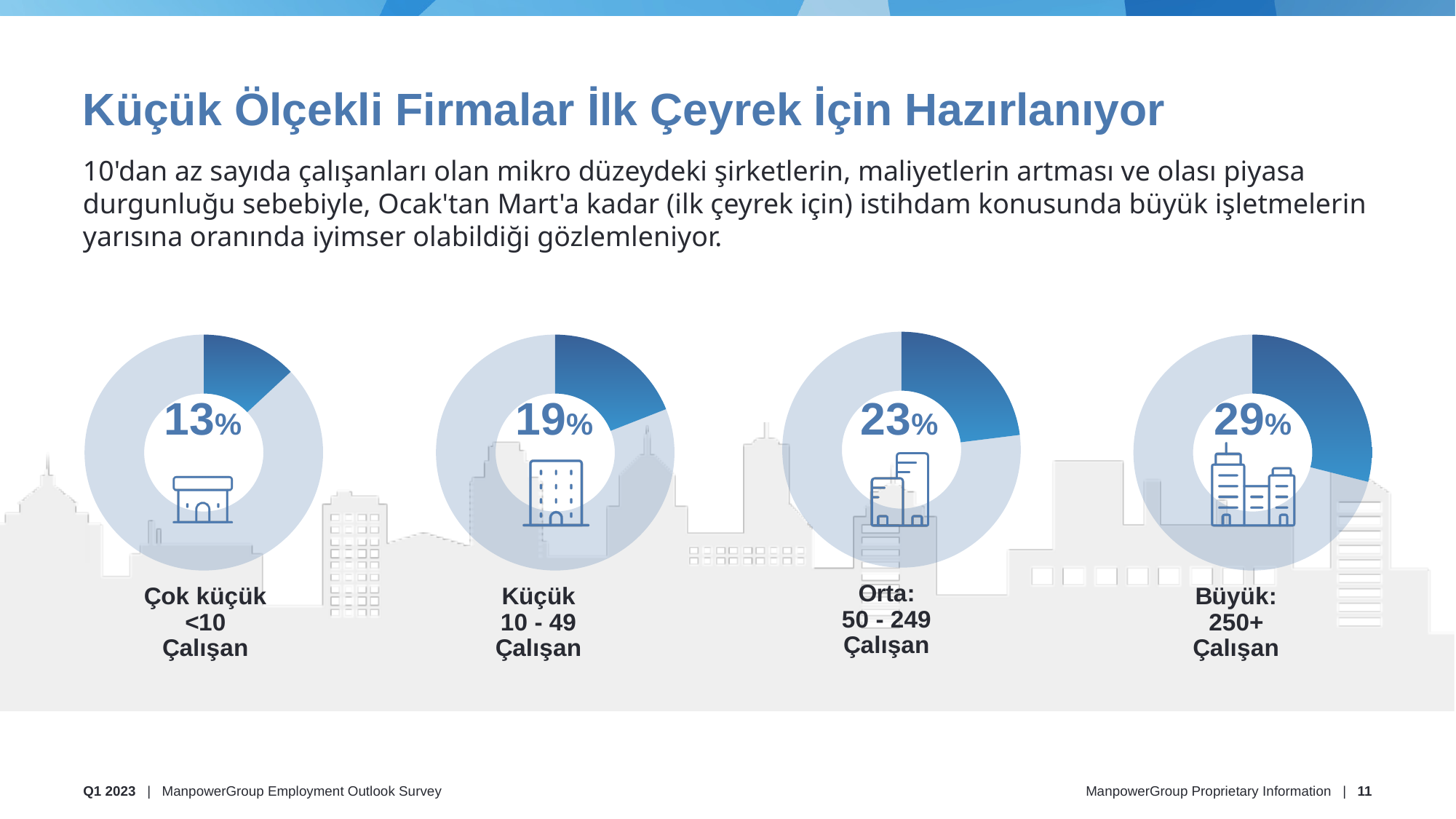
What kind of chart is used to show the values for each company size category? Donut chart Which company size category has the lowest value across the four donut charts? Çok küçük <10 Çalışan What is the difference between the value for 'Orta: 50 - 249 Çalışan' and the value for 'Küçük 10 - 49 Çalışan'? 4% Do the values rise or fall as company size increases from left to right across the charts? Rise What is the difference between the value for 'Büyük: 250+ Çalışan' and the value for 'Çok küçük <10 Çalışan'? 16% Which company size category has the highest value across the four donut charts? Büyük: 250+ Çalışan What value is shown in the donut chart for 'Küçük 10 - 49 Çalışan'? 19% What value is shown in the donut chart for 'Orta: 50 - 249 Çalışan'? 23% Which is larger: the value for 'Küçük 10 - 49 Çalışan' or the value for 'Orta: 50 - 249 Çalışan'? Orta: 50 - 249 Çalışan How many donut charts are shown on the slide? 4 What value is shown in the donut chart for 'Çok küçük <10 Çalışan'? 13% What value is shown in the donut chart for 'Büyük: 250+ Çalışan'? 29%